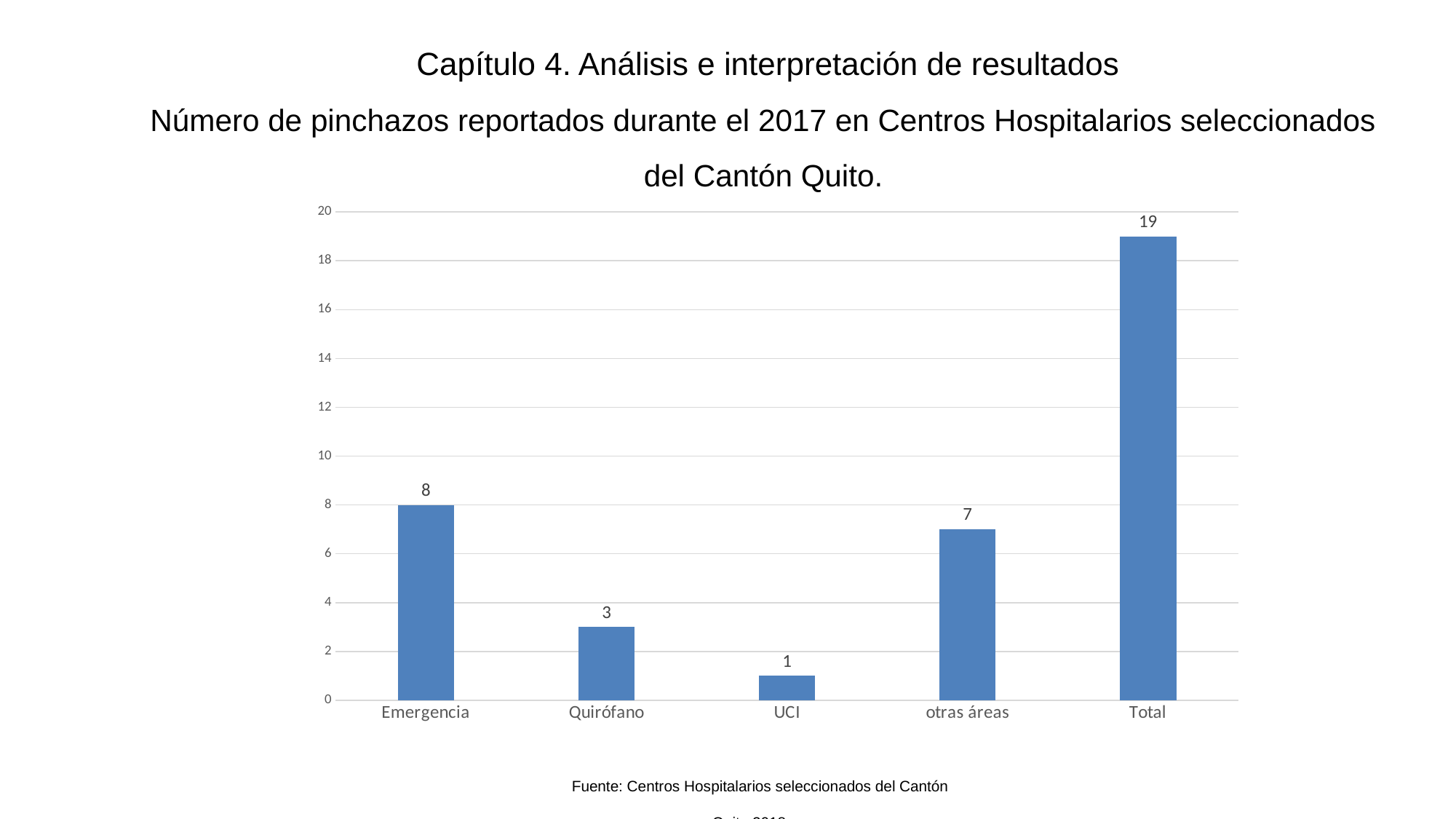
What is the value shown for otras áreas? 7 What is the number of pinchazos reported for Emergencia? 8 What is the difference between the values for Emergencia and otras áreas? 1 Excluding the Total bar, which category has the highest value? Emergencia Which category has the lowest value? UCI How many bars are plotted in the chart? 5 What is the value shown for the Total bar? 19 What kind of chart is shown on the slide? Bar chart What is the highest value shown on the vertical axis? 20 What is the value shown for UCI? 1 Which is larger, the value for Quirófano or the value for otras áreas? otras áreas What is the value shown for Quirófano? 3